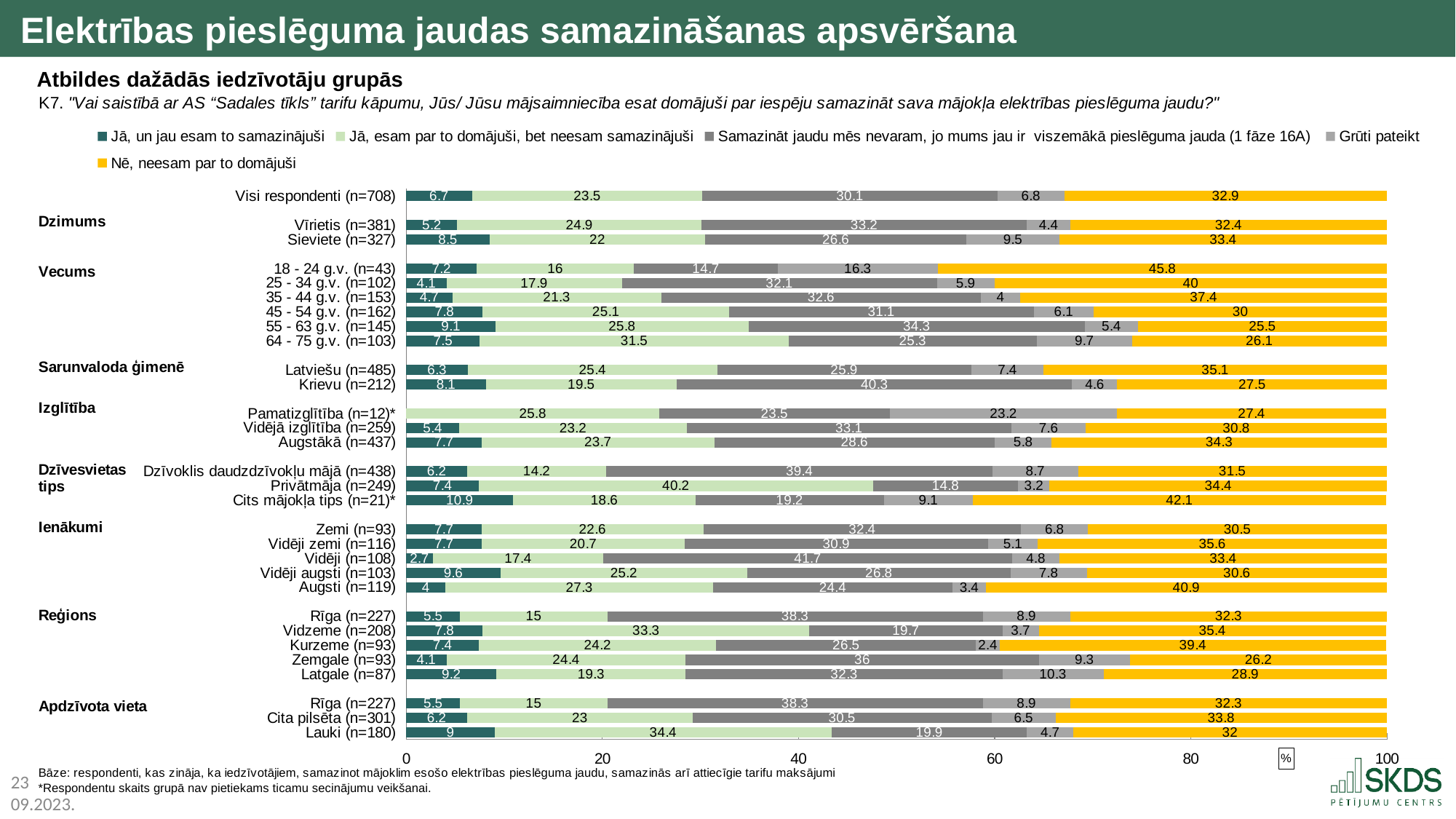
What is the value of "Jā, esam par to domājuši, bet neesam samazinājuši" for Privātmāja (n=249)? 40.2 Among the Ienākumi (income) groups, which has the lowest value for "Jā, un jau esam to samazinājuši"? Vidēji (n=108) How many categories are listed under Reģions? 5 What is the value of "Samazināt jaudu mēs nevaram, jo mums jau ir viszemākā pieslēguma jauda (1 fāze 16A)" for Krievu (n=212)? 40.3 How many series does the chart legend list? 5 Which has the larger value for "Samazināt jaudu mēs nevaram, jo mums jau ir viszemākā pieslēguma jauda (1 fāze 16A)": Rīga (n=227) or Lauki (n=180)? Rīga (n=227) What colour represents "Nē, neesam par to domājuši" in the chart? Yellow What kind of chart is shown on the slide? Stacked bar chart Among the Vecums (age) groups, which has the highest value for "Nē, neesam par to domājuši"? 18 - 24 g.v. (n=43) What is the difference between Krievu (n=212) and Latviešu (n=485) for "Samazināt jaudu mēs nevaram, jo mums jau ir viszemākā pieslēguma jauda (1 fāze 16A)"? 14.4 What is the value of "Nē, neesam par to domājuši" for Visi respondenti (n=708)? 32.9 What is the value of "Jā, un jau esam to samazinājuši" for Cits mājokļa tips (n=21)*? 10.9